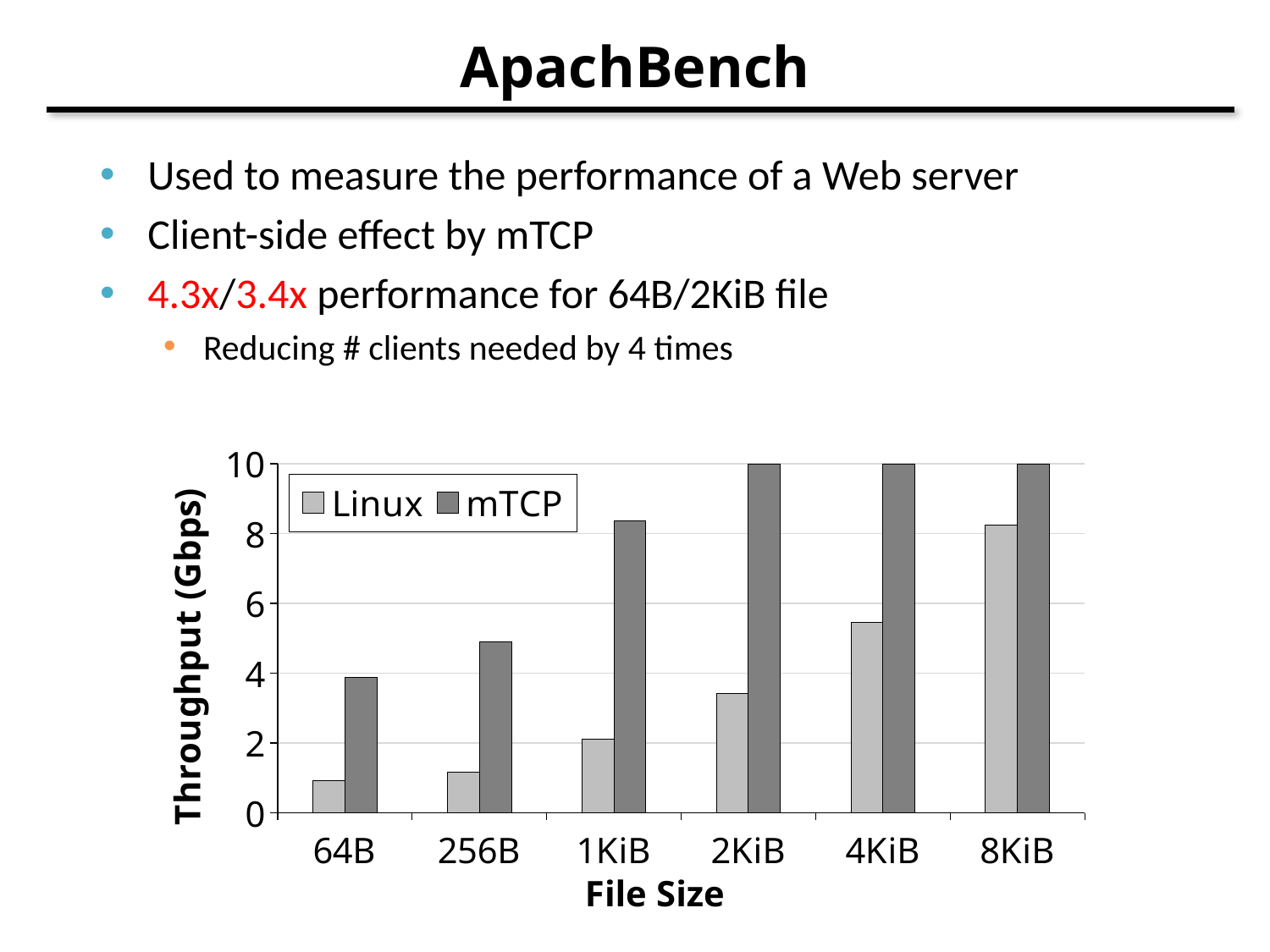
Is the mTCP throughput for 1KiB greater or less than 8? greater Does the Linux throughput rise or fall as file size increases along the x axis? rise What is the label of the x axis? File Size How many series does the legend list? 2 What kind of chart is shown on the slide? bar chart What is the label of the y axis? Throughput (Gbps) How many file size categories are shown on the x axis? 6 Which file size has the highest Linux throughput? 8KiB Is the Linux throughput for 4KiB greater or less than 4? greater For the 2KiB file size, which series has the higher throughput, Linux or mTCP? mTCP Which file size has the lowest Linux throughput? 64B Is the Linux throughput for 64B greater or less than 2? less